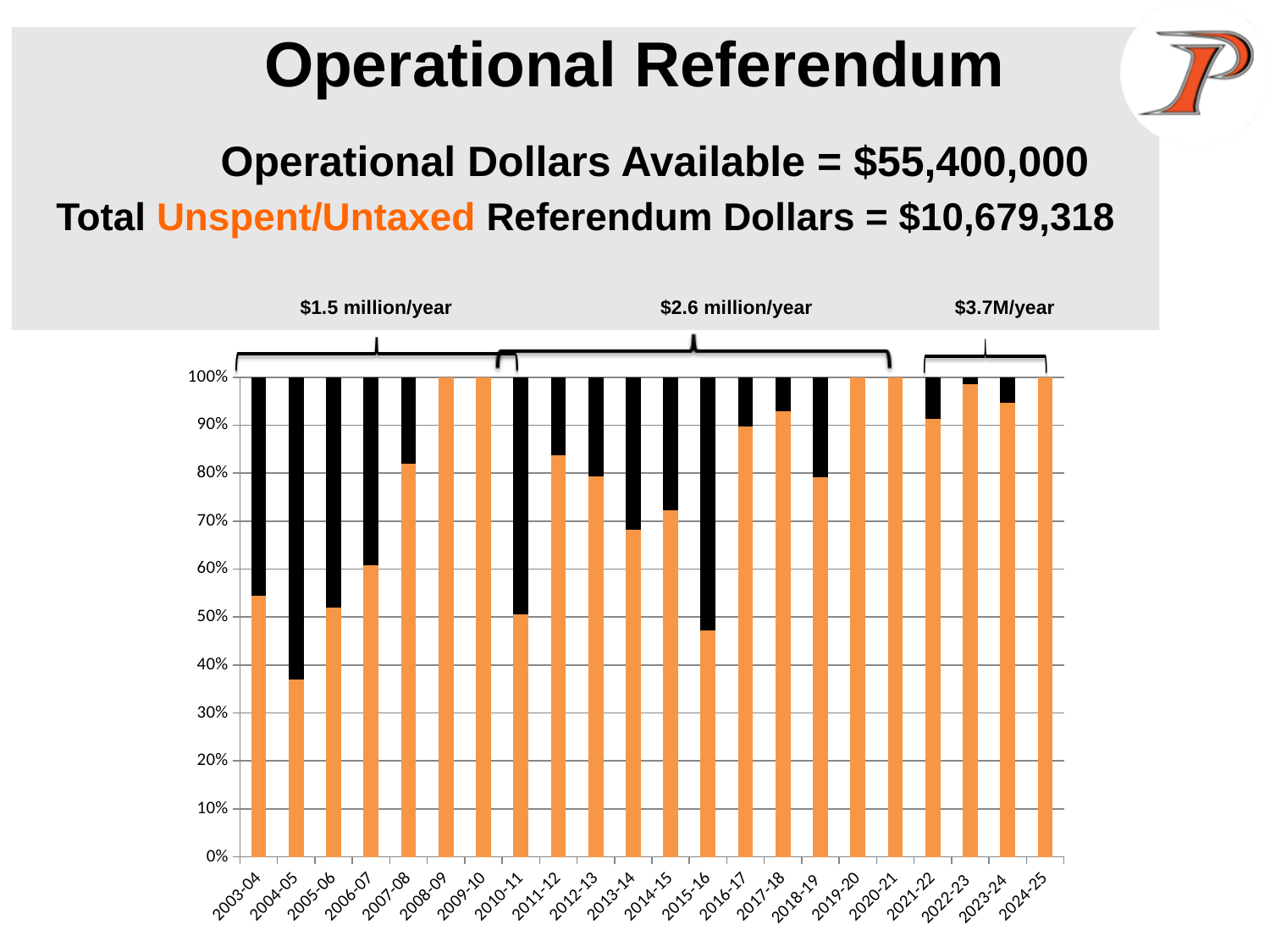
What is the total height of the stacked bar for 2003-04? 100% Is the orange segment for 2017-18 greater or less than 90%? greater Is the orange segment for 2004-05 greater or less than 40%? less How many school years are shown along the x axis of the chart? 22 Which year has the lowest orange segment in the chart? 2004-05 Is the orange segment for 2013-14 greater or less than 70%? less What kind of chart is shown on the slide? stacked bar chart Which has the larger orange segment, 2007-08 or 2010-11? 2007-08 What value does the orange bar for 2008-09 reach on the axis? 100% What annual amount is labelled above the bracket covering 2021-22 to 2024-25? $3.7M/year